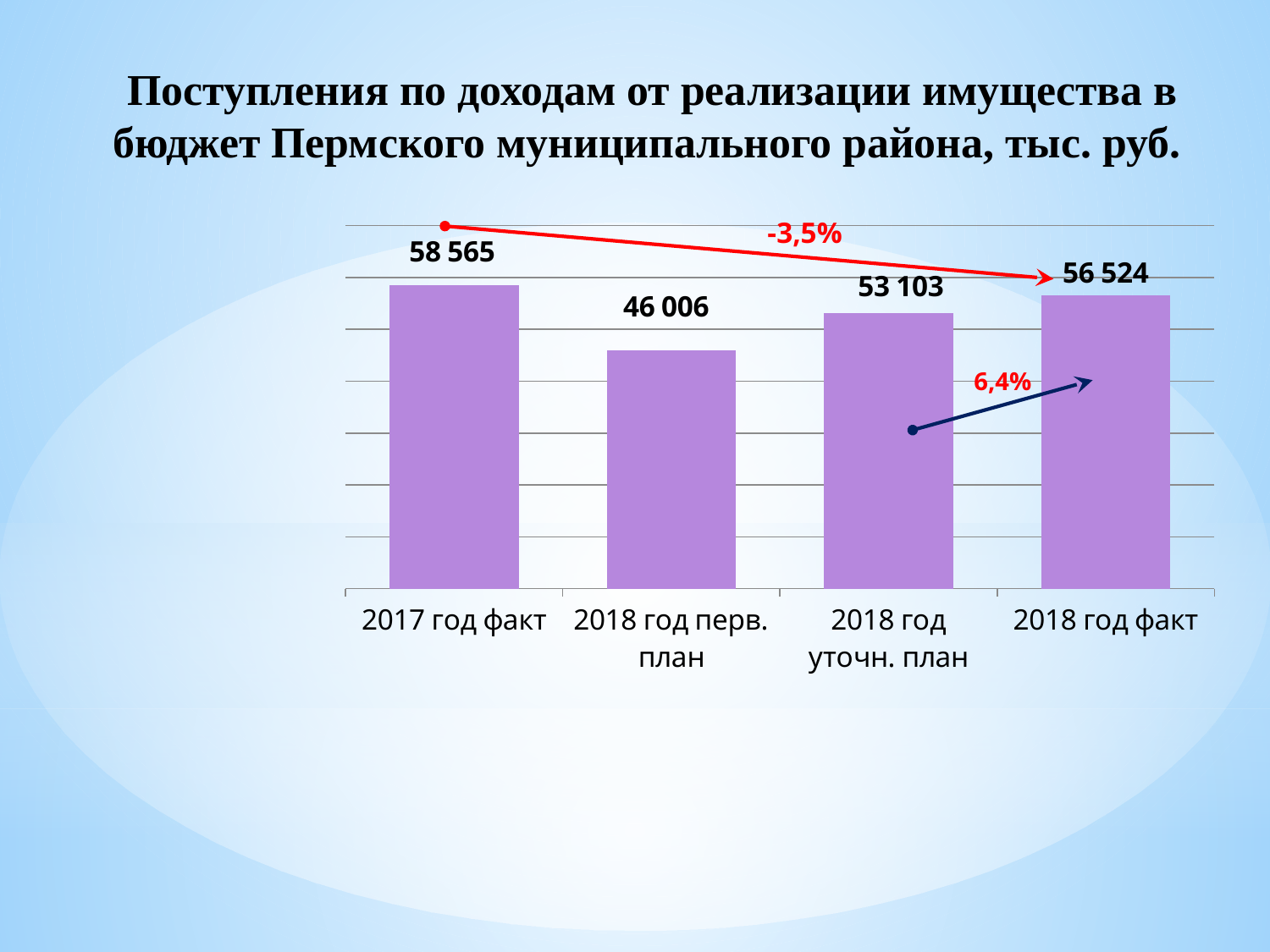
Which category has the lowest value? 2018 год перв. план What is the value for 2017 год факт? 58 565 What is the difference between the values for 2018 год факт and 2018 год перв. план? 10 518 How many categories are shown on the x axis? 4 What is the value for 2018 год уточн. план? 53 103 What is the difference between the values for 2017 год факт and 2018 год факт? 2 041 What kind of chart is shown on the slide? bar chart Which is larger, the value for 2018 год уточн. план or the value for 2018 год факт? 2018 год факт What is the value for 2018 год перв. план? 46 006 What percentage change is shown by the red arrow from 2017 год факт to 2018 год факт? -3,5% Which category has the highest value? 2017 год факт What is the value for 2018 год факт? 56 524